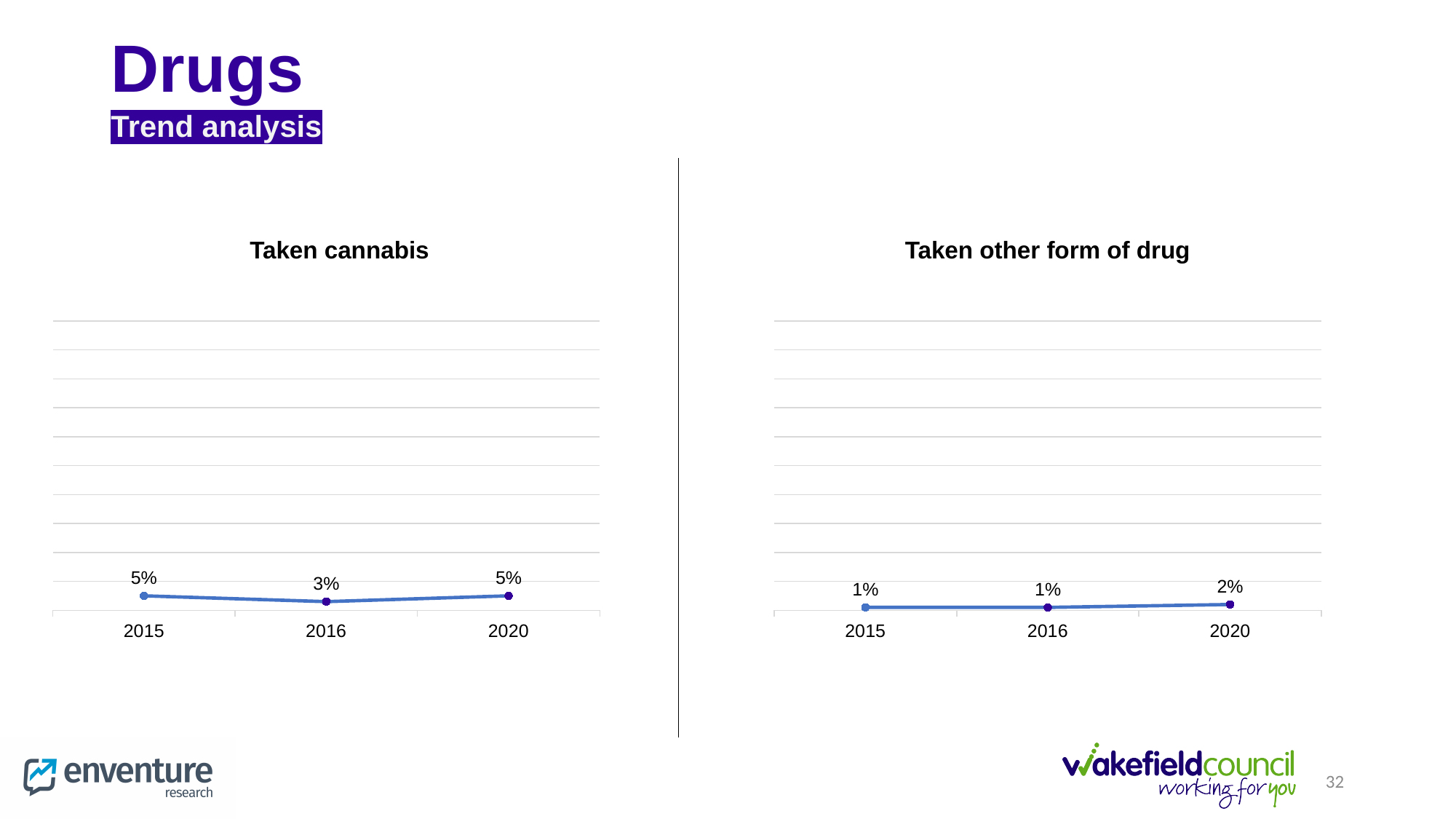
In the 'Taken other form of drug' chart, what is the value for 2015? 1% In the 'Taken other form of drug' chart, what is the value for 2020? 2% In the 'Taken cannabis' chart, what is the value for 2015? 5% In the 'Taken cannabis' chart, what is the difference between the 2015 value and the 2016 value? 2% In the 'Taken other form of drug' chart, does the value rise or fall from 2016 to 2020? rise In the 'Taken cannabis' chart, what is the value for 2016? 3% In the 'Taken other form of drug' chart, what is the difference between the 2020 value and the 2016 value? 1% In the 'Taken other form of drug' chart, which year has the highest value? 2020 What kind of chart is the 'Taken cannabis' chart? line chart In the 'Taken cannabis' chart, which year has the lowest value? 2016 How many years are plotted in the 'Taken other form of drug' chart? 3 In the 'Taken cannabis' chart, is the value for 2020 larger or smaller than the value for 2016? larger